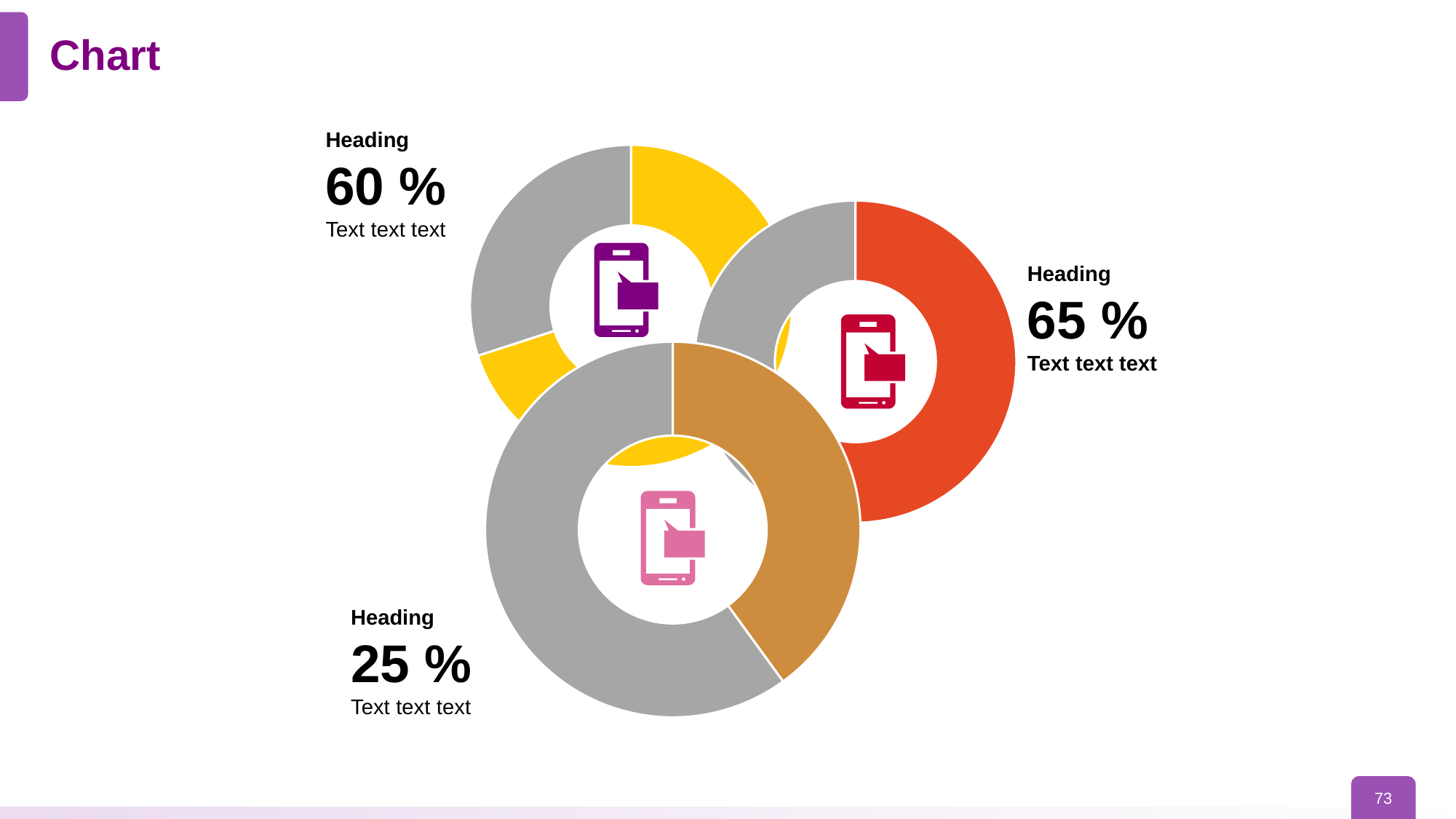
Which is larger: the percentage on the top-left (yellow) donut chart or the bottom (brown) donut chart? The top-left (yellow) chart, 60 % What is the difference between the percentage on the right (red) donut chart and the bottom (brown) donut chart? 40 % What percentage is shown for the bottom donut chart (brown)? 25 % Which donut chart shows the lowest percentage? The bottom (brown) chart, 25 % What percentage is shown for the right donut chart (red)? 65 % What colour is the highlighted segment of the donut chart labelled 65 %? Red What is the difference between the percentage on the right (red) donut chart and the top-left (yellow) donut chart? 5 % What kind of charts are shown on the slide? Donut (pie) charts What is the title of the slide? Chart Which donut chart shows the highest percentage? The right (red) chart, 65 % How many donut charts are on the slide? 3 What percentage is shown for the top-left donut chart (yellow)? 60 %